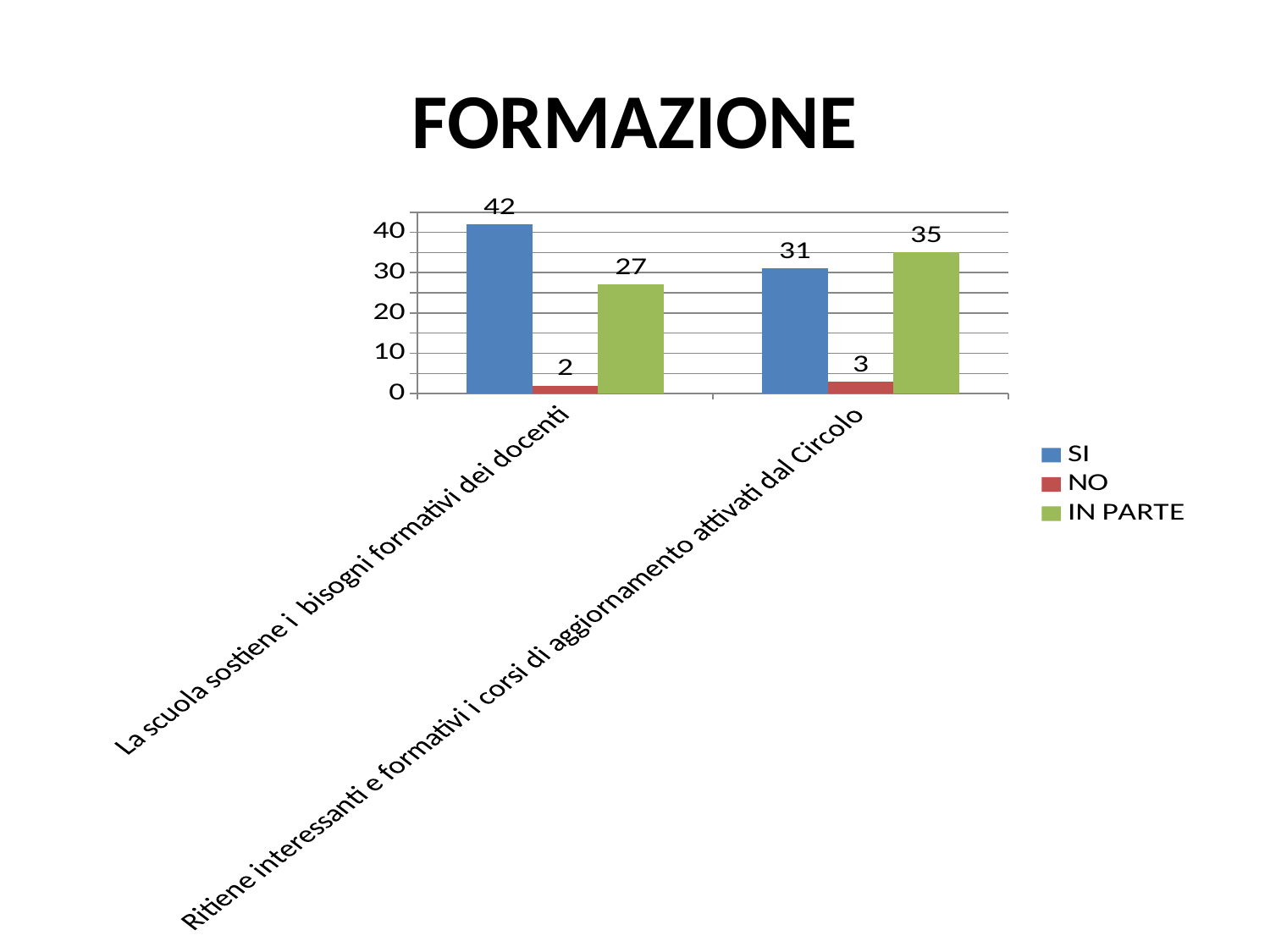
What is the NO value for "La scuola sostiene i bisogni formativi dei docenti"? 2 What is the difference between the SI and IN PARTE values for "La scuola sostiene i bisogni formativi dei docenti"? 15 What is the title of the slide? FORMAZIONE What kind of chart is shown on the slide? Bar chart How many categories are shown on the x axis? 2 What is the SI value for "La scuola sostiene i bisogni formativi dei docenti"? 42 Which series has the lowest value for "Ritiene interessanti e formativi i corsi di aggiornamento attivati dal Circolo"? NO How many series does the legend list? 3 What is the SI value for "Ritiene interessanti e formativi i corsi di aggiornamento attivati dal Circolo"? 31 For "Ritiene interessanti e formativi i corsi di aggiornamento attivati dal Circolo", which is larger: SI or IN PARTE? IN PARTE Which series has the highest value for "La scuola sostiene i bisogni formativi dei docenti"? SI What is the IN PARTE value for "Ritiene interessanti e formativi i corsi di aggiornamento attivati dal Circolo"? 35